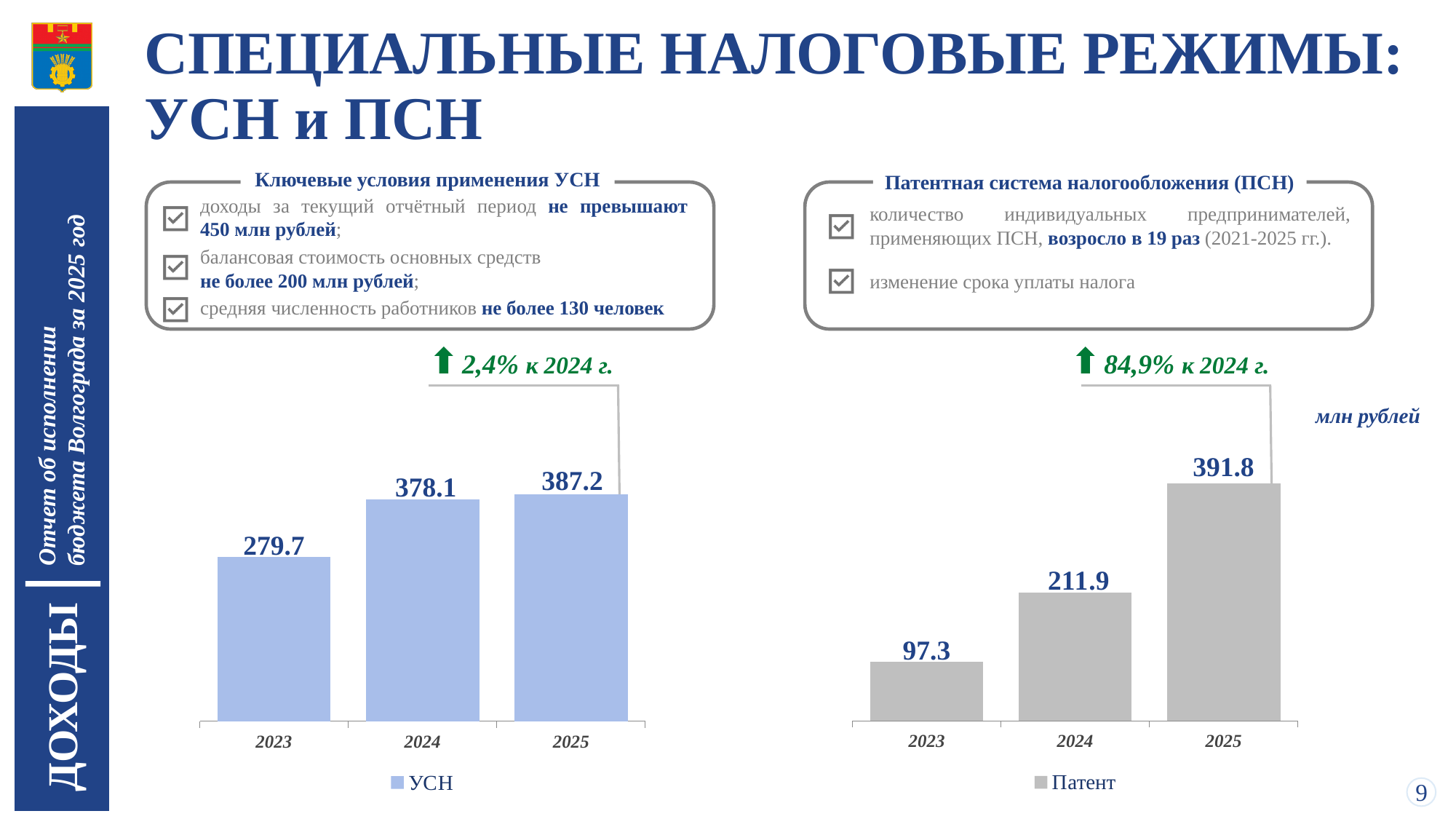
In the right chart (Патент), what is the value for 2024? 211.9 In the left chart (УСН), what is the value for 2023? 279.7 In the right chart (Патент), what is the difference between the 2025 and 2024 values? 179.9 In the right chart (Патент), which year has the highest value? 2025 In the left chart (УСН), what is the value for 2025? 387.2 How many years are shown in the right chart (Патент)? 3 In the right chart (Патент), what is the value for 2023? 97.3 In the left chart (УСН), what is the difference between the 2025 and 2024 values? 9.1 In the left chart (УСН), which year has the lowest value? 2023 Which is larger: the 2025 value in the left chart (УСН) or the 2025 value in the right chart (Патент)? Патент (391.8) In the right chart (Патент), do the values rise or fall from 2023 to 2025? rise What type of chart is the left chart (УСН)? bar chart